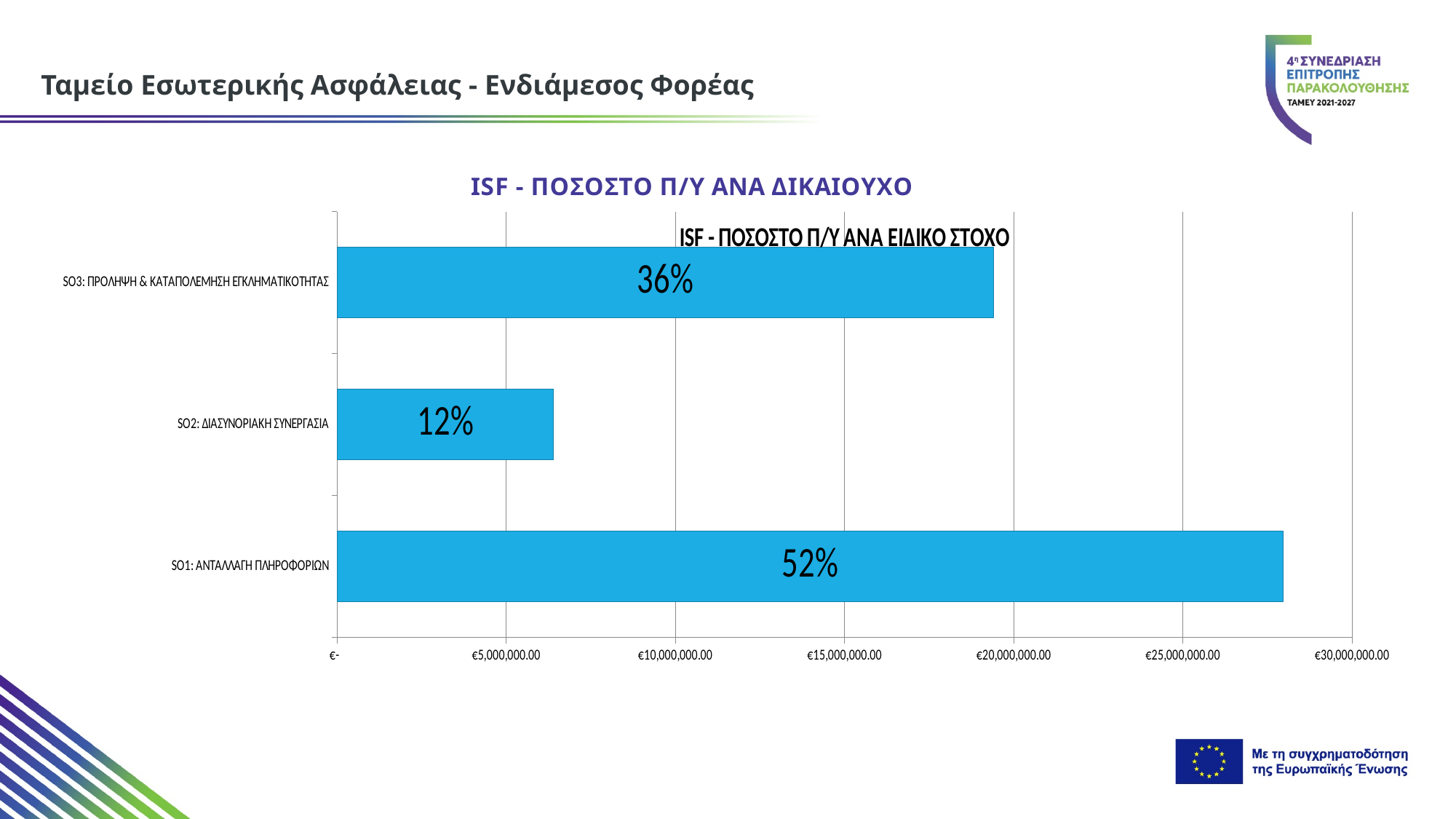
Which specific objective has the largest bar in the chart? SO1: ΑΝΤΑΛΛΑΓΗ ΠΛΗΡΟΦΟΡΙΩΝ What is the data label shown on the bar for SO2: ΔΙΑΣΥΝΟΡΙΑΚΗ ΣΥΝΕΡΓΑΣΙΑ? 12% What type of chart is shown on the slide? Bar chart What is the difference in percentage points between the labels for SO1 and SO3? 16% What is the data label shown on the bar for SO3: ΠΡΟΛΗΨΗ & ΚΑΤΑΠΟΛΕΜΗΣΗ ΕΓΚΛΗΜΑΤΙΚΟΤΗΤΑΣ? 36% Which specific objective has the smallest bar in the chart? SO2: ΔΙΑΣΥΝΟΡΙΑΚΗ ΣΥΝΕΡΓΑΣΙΑ How many specific objectives (categories) are plotted in the chart? 3 What is the data label shown on the bar for SO1: ΑΝΤΑΛΛΑΓΗ ΠΛΗΡΟΦΟΡΙΩΝ? 52% Is the value for SO2 greater or less than €10,000,000.00? less Is the value for SO3 greater or less than €15,000,000.00? greater Which has a larger share, SO3 or SO2? SO3: ΠΡΟΛΗΨΗ & ΚΑΤΑΠΟΛΕΜΗΣΗ ΕΓΚΛΗΜΑΤΙΚΟΤΗΤΑΣ What is the difference in percentage points between the labels for SO1 and SO2? 40%